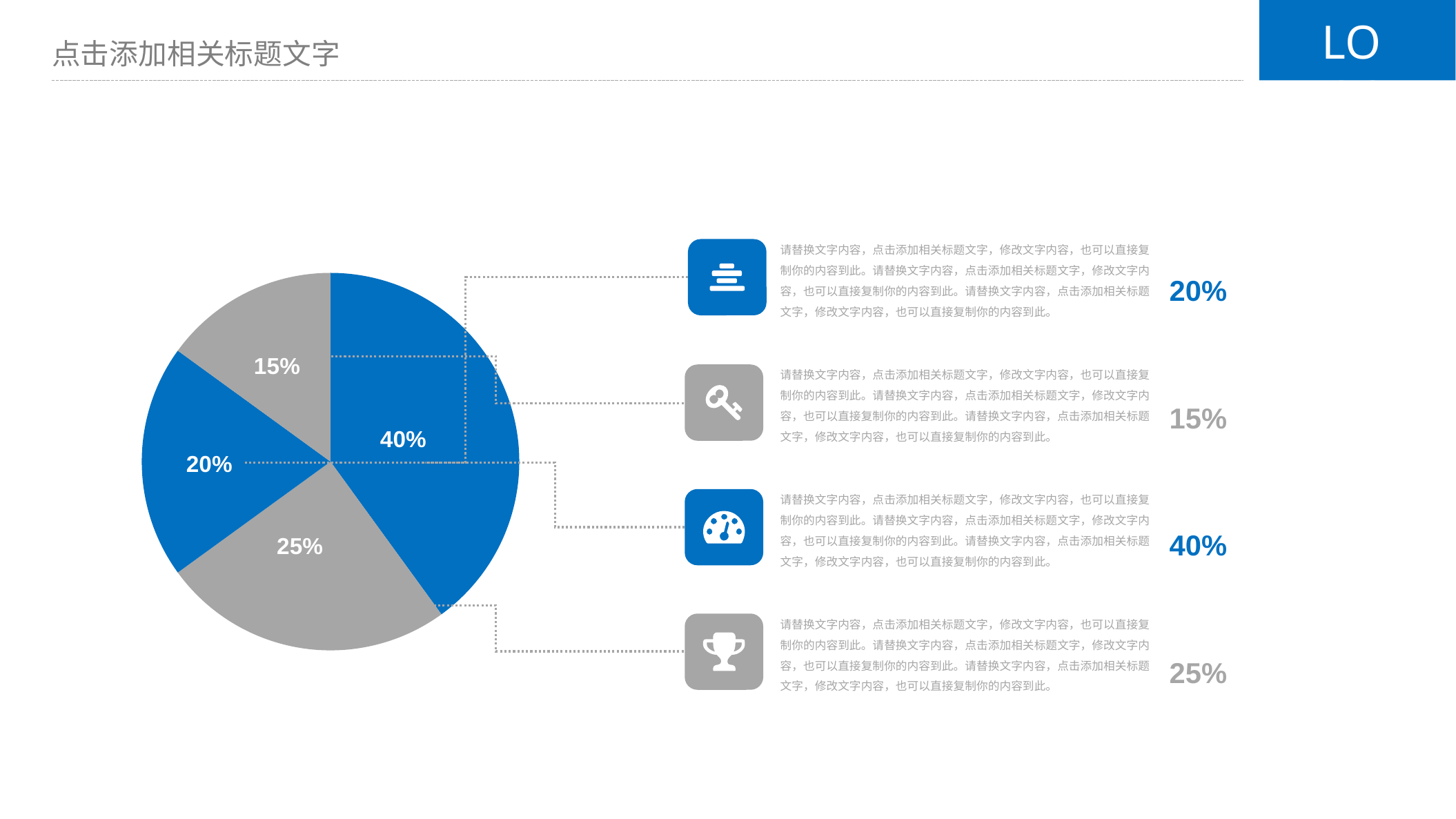
What share of the pie does the largest blue slice represent? 40% What is the smallest slice of the pie chart? 15% What colour is the 15% slice of the pie chart? grey Which is larger, the slice labelled 25% or the slice labelled 20%? 25% What colour is the 40% slice of the pie chart? blue What is the difference between the largest and smallest slices of the pie chart? 25% What kind of chart is shown on the slide? pie chart What is the combined share of the two blue slices in the pie chart? 60% What is the difference between the 25% slice and the 20% slice? 5% What is the combined share of the two grey slices in the pie chart? 40% How many slices does the pie chart have? 4 What is the largest slice of the pie chart? 40%